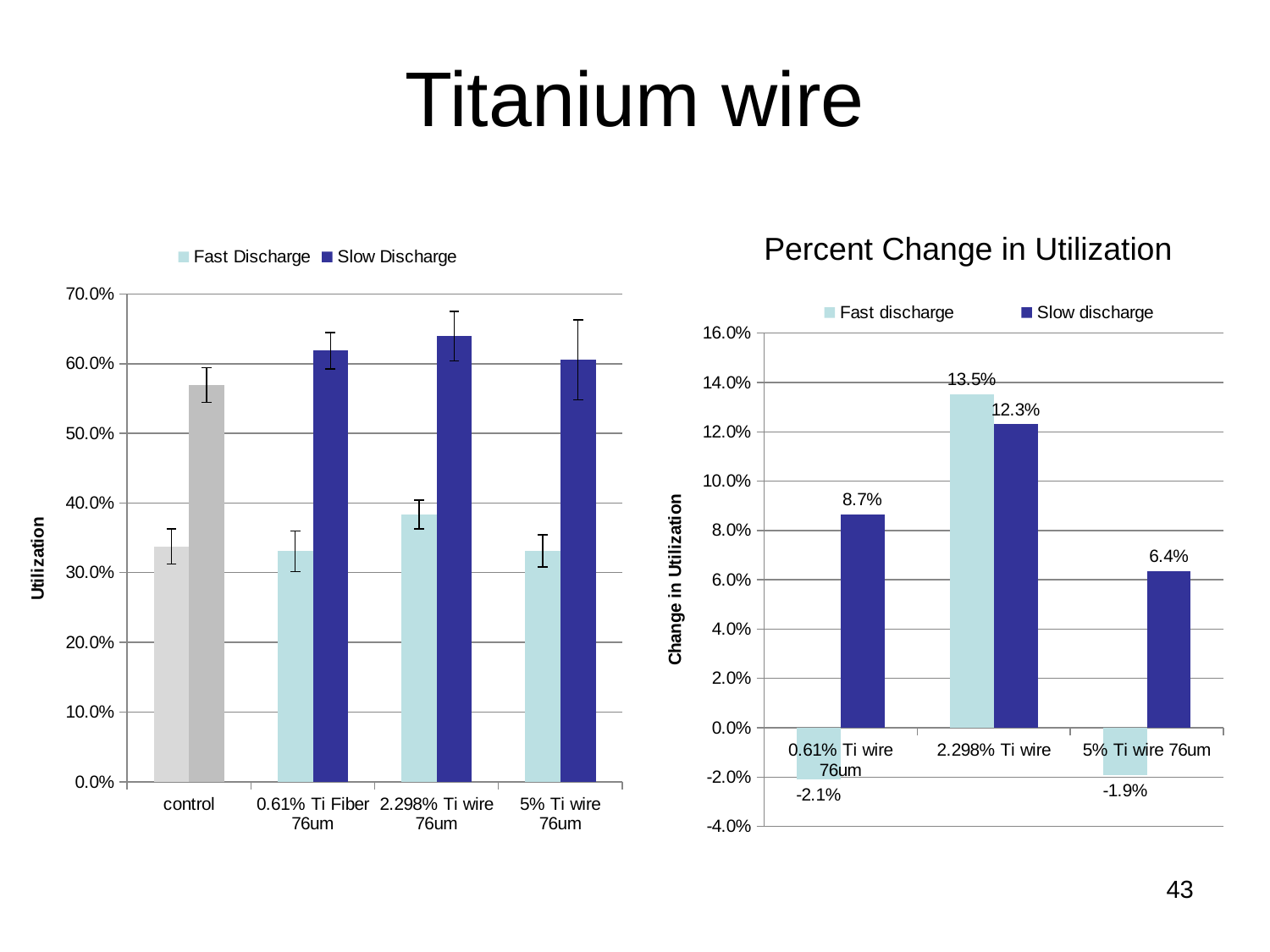
In the 'Percent Change in Utilization' chart, how many categories are shown on the x axis? 3 What kind of chart is the 'Percent Change in Utilization' chart? Bar chart In the left chart with the 'Utilization' y axis, is the Fast Discharge value for 2.298% Ti wire 76um greater or less than 40.0%? less In the 'Percent Change in Utilization' chart, what is the Fast discharge value for 2.298% Ti wire? 13.5% In the 'Percent Change in Utilization' chart, what is the Fast discharge value for 5% Ti wire 76um? -1.9% In the 'Percent Change in Utilization' chart, what is the Slow discharge value for 0.61% Ti wire 76um? 8.7% In the 'Percent Change in Utilization' chart, which category has the highest Slow discharge value? 2.298% Ti wire In the 'Percent Change in Utilization' chart, which is larger for 5% Ti wire 76um: Fast discharge or Slow discharge? Slow discharge In the left chart with the 'Utilization' y axis, how many series does the legend list? 2 In the 'Percent Change in Utilization' chart, which category has the lowest Fast discharge value? 0.61% Ti wire 76um In the 'Percent Change in Utilization' chart, what is the difference between the Fast discharge and Slow discharge values for 2.298% Ti wire? 1.2% In the left chart with the 'Utilization' y axis, is the Slow Discharge value for control greater or less than 50.0%? greater